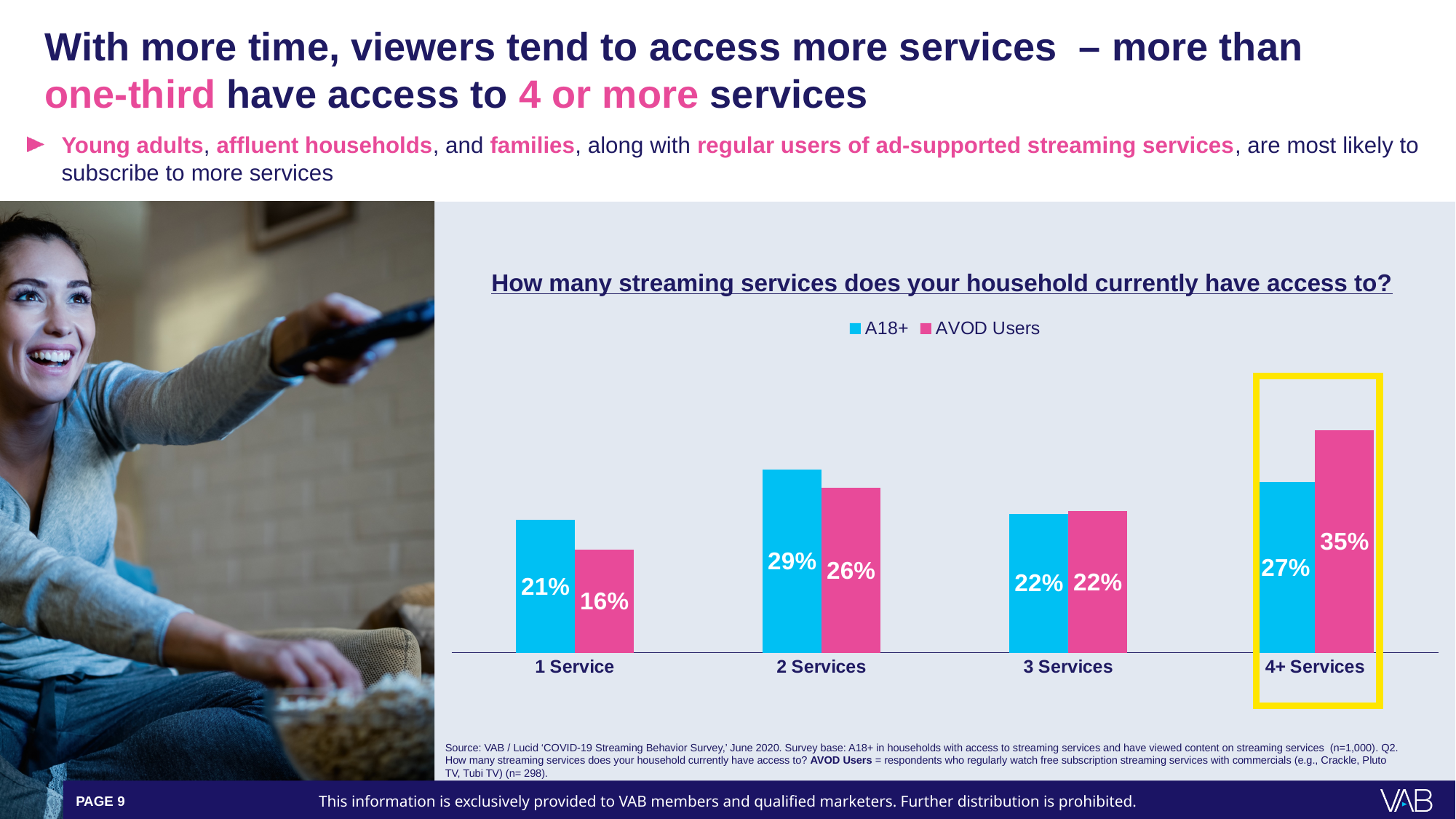
What is the AVOD Users value for 2 Services? 26% Which category is highlighted with a yellow box? 4+ Services How many categories are shown on the x axis? 4 For 1 Service, which is larger: the A18+ value or the AVOD Users value? A18+ Which category has the lowest AVOD Users value? 1 Service What is the title of the chart? How many streaming services does your household currently have access to? How many series does the legend list? 2 What is the AVOD Users value for 4+ Services? 35% What kind of chart is shown on the slide? Bar chart What is the difference between the AVOD Users and A18+ values for 4+ Services? 8% Which category has the highest A18+ value? 2 Services What is the A18+ value for 1 Service? 21%